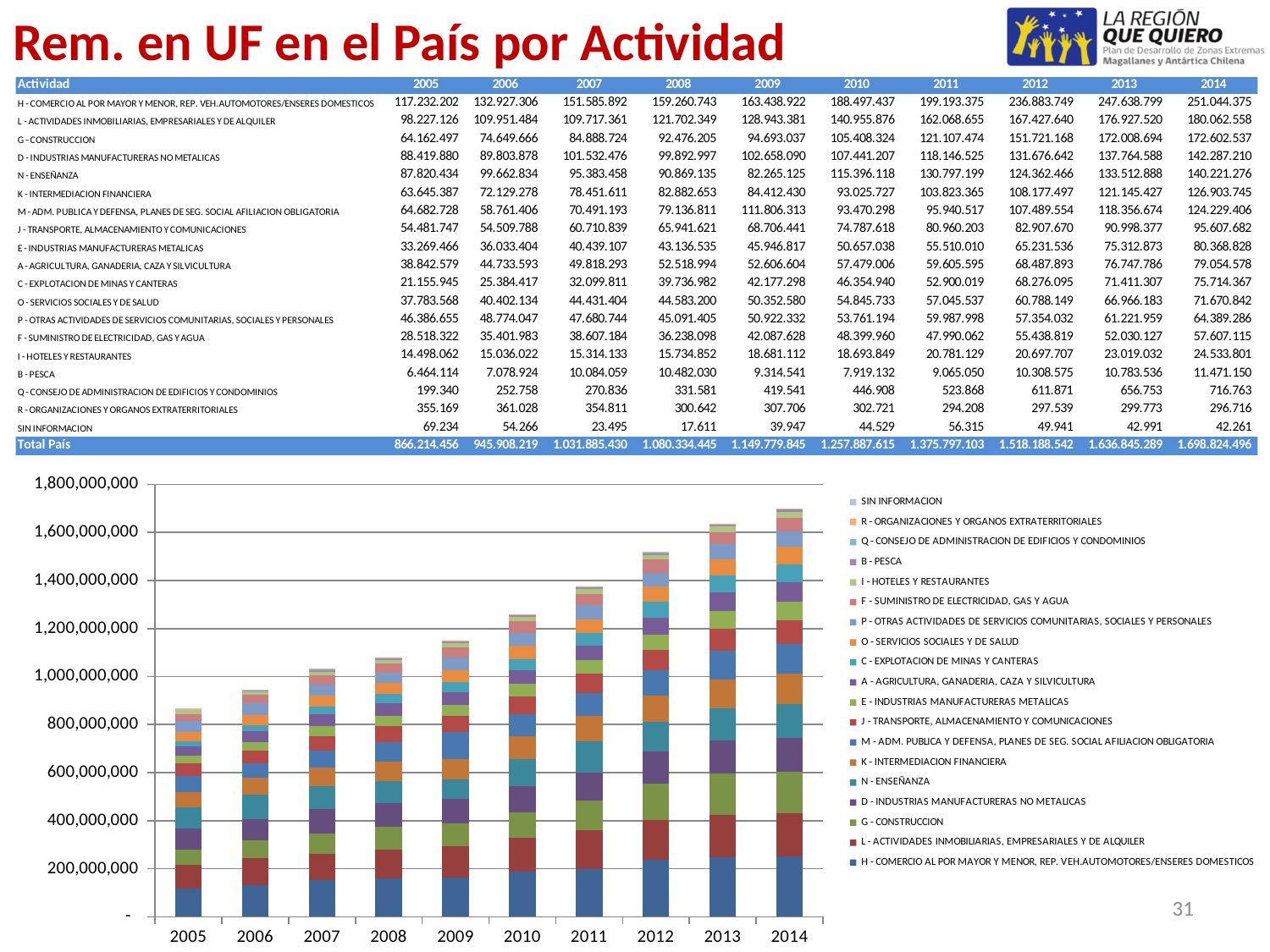
Which series is listed last (at the bottom) in the chart legend? H - COMERCIO AL POR MAYOR Y MENOR, REP. VEH.AUTOMOTORES/ENSERES DOMESTICOS Is the total bar for 2014 greater or less than 1,600,000,000? greater Which year has the highest total bar in the chart? 2014 Using the Total País values in the table, what is the difference between the 2014 total and the 2005 total? 832.610.040 Is the total bar for 2005 greater or less than 1,000,000,000? less Which year has the lowest total bar in the chart? 2005 According to the table, what is the value for H - COMERCIO AL POR MAYOR Y MENOR in 2014? 251.044.375 Do the total bar heights rise or fall from 2005 to 2014? Rise How many years are shown on the x axis of the chart? 10 What kind of chart is shown on the slide? Stacked bar chart According to the Total País row of the table, what is the total for 2014? 1.698.824.496 How many series does the chart legend list? 19